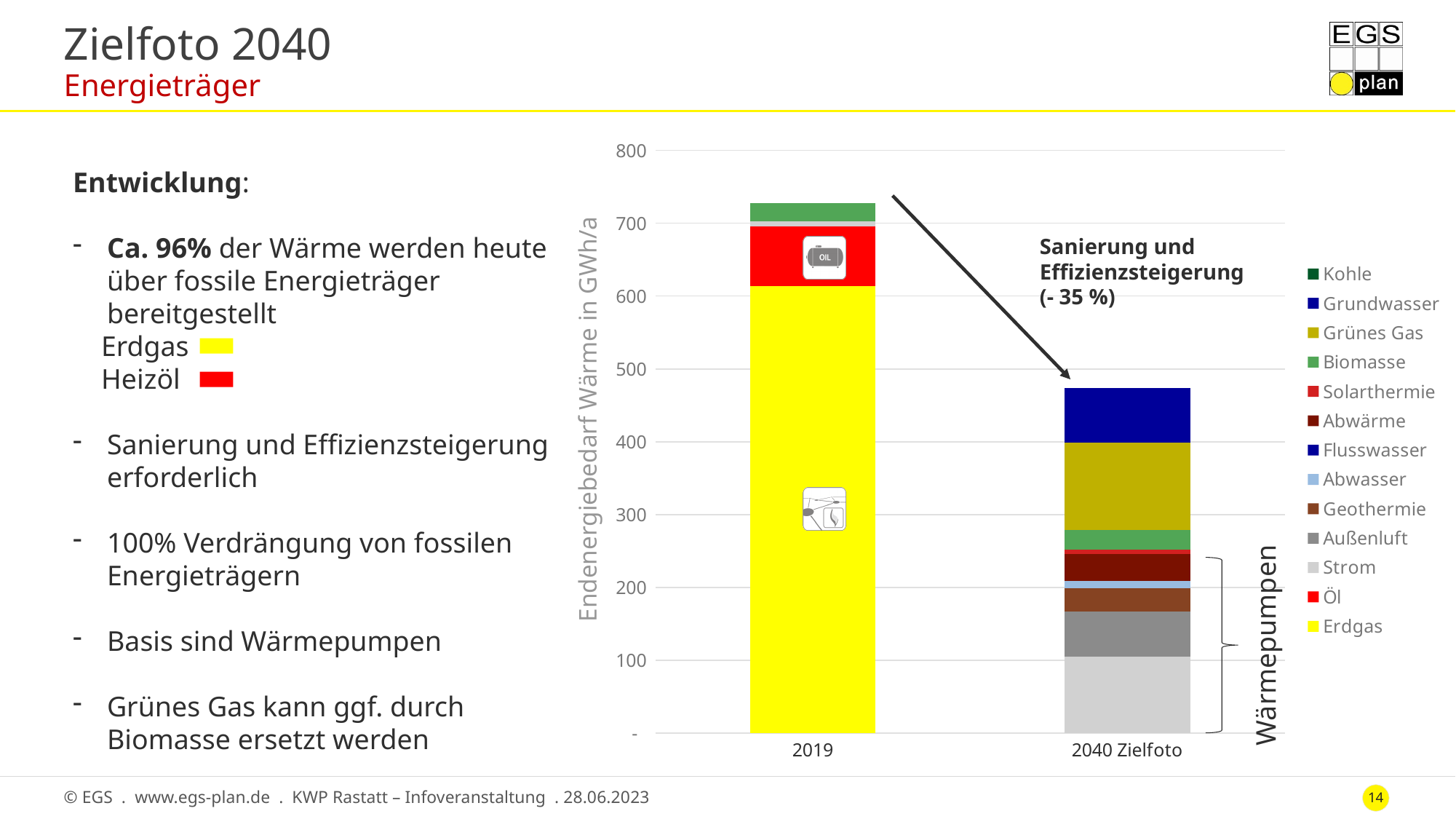
What kind of chart is shown on the slide? stacked bar chart Which bar is taller, 2019 or 2040 Zielfoto? 2019 How many series does the legend list? 13 What is the label of the y axis? Endenergiebedarf Wärme in GWh/a How many bars (categories) are plotted on the x axis? 2 Does the total energy demand rise or fall from 2019 to 2040 Zielfoto? fall Is the total height of the 2019 bar greater or less than 700? greater Is the Erdgas segment of the 2019 bar greater or less than 500? greater Is the total height of the 2040 Zielfoto bar greater or less than 500? less What percentage reduction is stated in the annotation next to the arrow between the bars? - 35 %